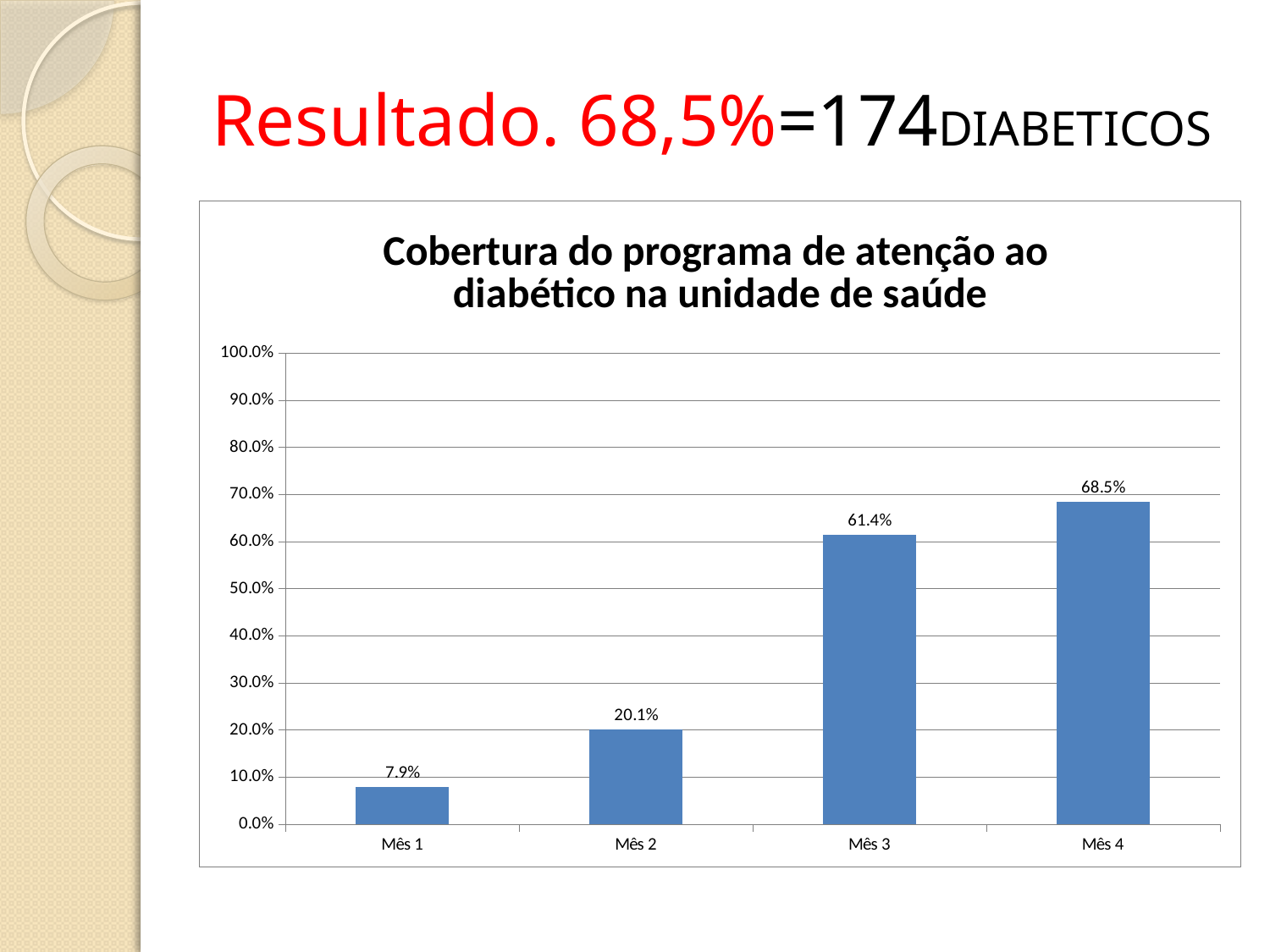
What kind of chart is shown on the slide? Bar chart What is the difference between the values for Mês 2 and Mês 1? 12.2% Which month has the lowest coverage value? Mês 1 Which is larger, the value for Mês 2 or the value for Mês 3? Mês 3 What is the value for Mês 2? 20.1% What is the value for Mês 1? 7.9% How many months (categories) are shown on the x axis? 4 Which month has the highest coverage value? Mês 4 Do the values rise or fall from Mês 1 to Mês 4? Rise What is the difference between the values for Mês 4 and Mês 3? 7.1% What is the value for Mês 3? 61.4% What is the value for Mês 4? 68.5%